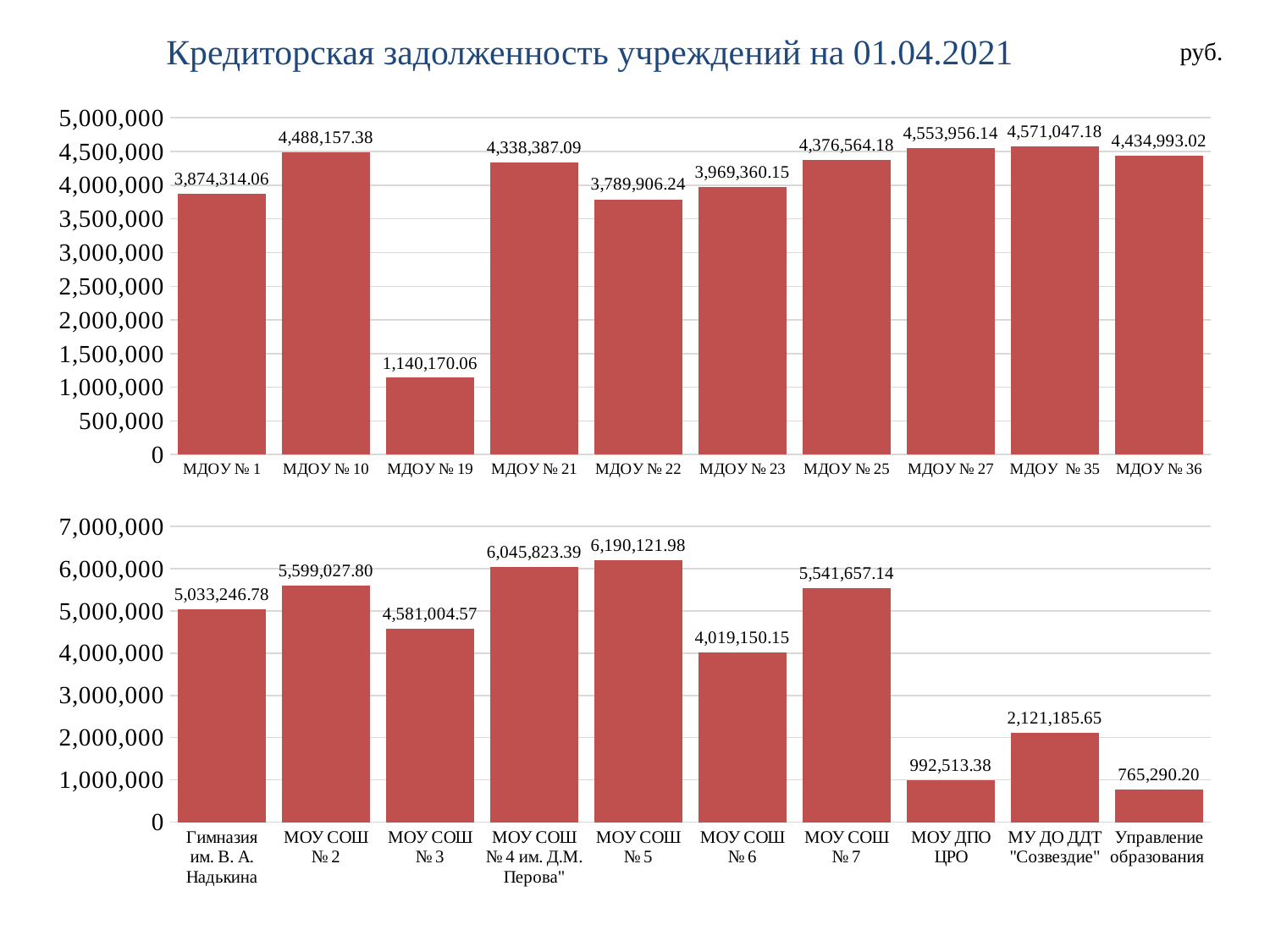
On the bottom chart, which category has the lowest value? Управление образования On the top chart, how many categories are shown? 10 On the top chart, what is the value for МДОУ № 19? 1,140,170.06 What kind of chart is the bottom chart? Bar chart On the bottom chart, what is the value for МОУ ДПО ЦРО? 992,513.38 On the top chart, what is the value for МДОУ № 25? 4,376,564.18 On the top chart, which category has the highest value? МДОУ № 35 On the bottom chart, what is the difference between the values for МОУ СОШ № 5 and МОУ СОШ № 4 им. Д.М. Перова? 144,298.59 On the bottom chart, which category has the highest value? МОУ СОШ № 5 On the top chart, which category has the lowest value? МДОУ № 19 On the top chart, what is the difference between the values for МДОУ № 10 and МДОУ № 19? 3,347,987.32 On the bottom chart, which is larger: the value for МОУ СОШ № 2 or МОУ СОШ № 7? МОУ СОШ № 2